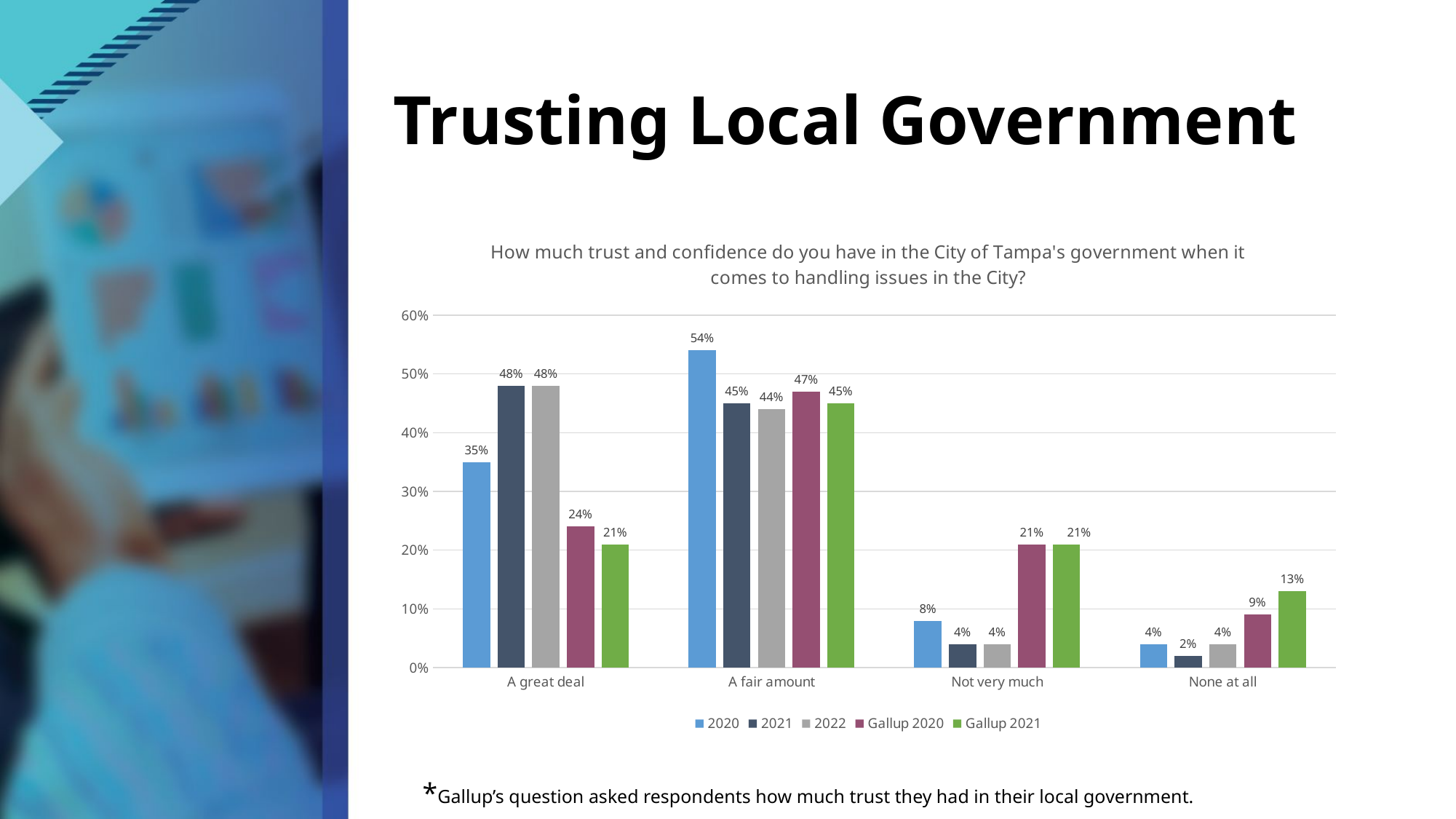
Which category has the highest value for the 2021 series? A great deal What kind of chart is shown on the slide? Bar chart What is the difference between the 2020 and Gallup 2021 values in the 'A great deal' category? 14% How many categories are shown on the x axis? 4 How many series does the legend list? 5 Which series is shown in green in the legend? Gallup 2021 What is the value for the 2020 series in the 'A fair amount' category? 54% What is the value for 2022 in the 'A great deal' category? 48% What is the value for Gallup 2021 in the 'None at all' category? 13% Is the value for 2020 in the 'A fair amount' category greater or less than 50%? greater In the 'Not very much' category, which is larger: the 2020 value or the Gallup 2020 value? Gallup 2020 Which category has the lowest value for the Gallup 2020 series? None at all